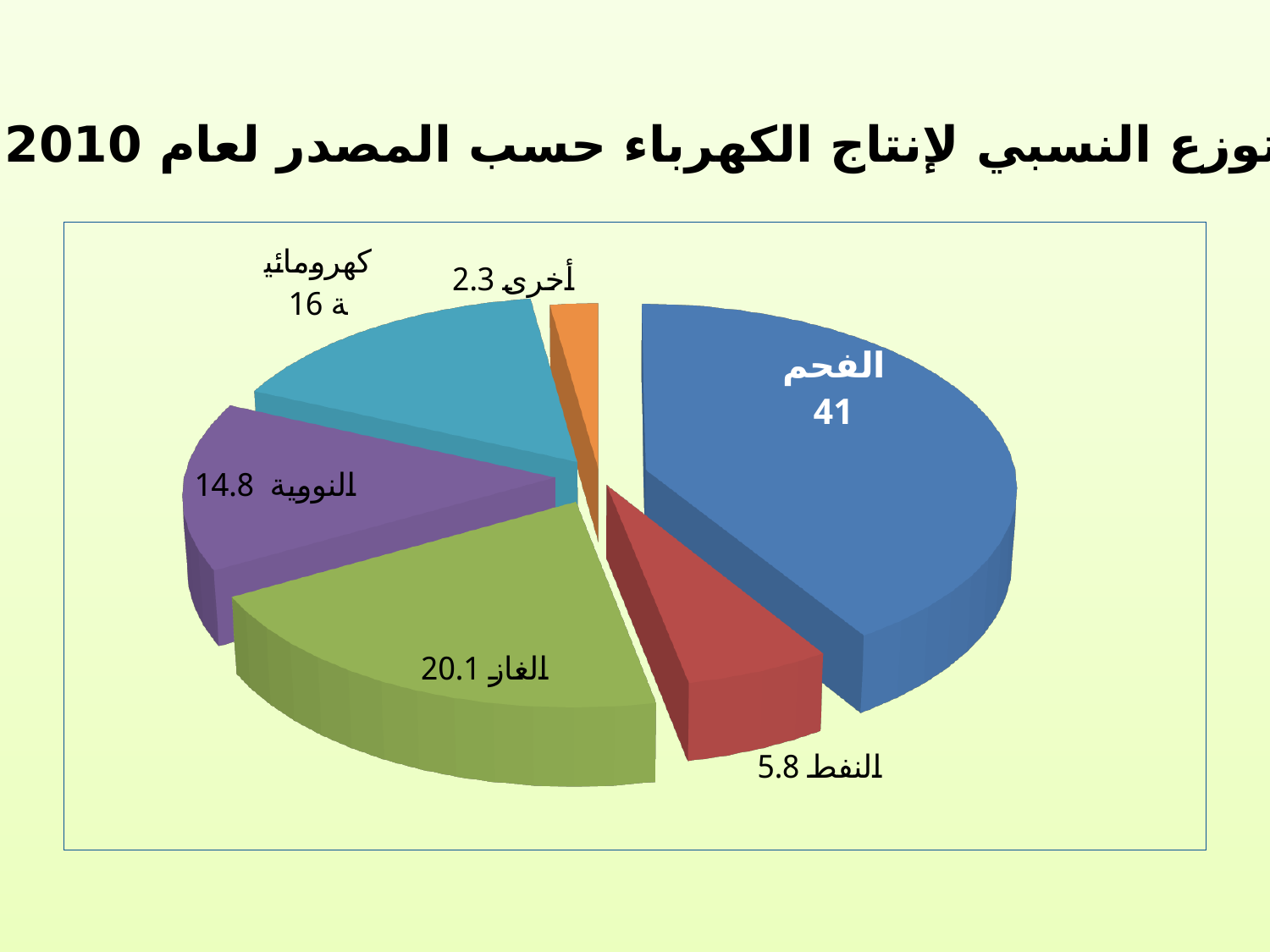
What is the value shown for كهرومائية (hydro) in the pie chart? 16 What colour is the slice for الفحم (coal)? Blue Which source has the smallest slice in the pie chart? أخرى What is the value shown for الغاز (gas) in the pie chart? 20.1 What is the value shown for النفط (oil) in the pie chart? 5.8 How many slices does the pie chart have? 6 What is the difference between the values for الفحم (coal) and الغاز (gas)? 20.9 What type of chart is shown on the slide? Pie chart Which is larger, the value for كهرومائية (hydro) or النووية (nuclear)? كهرومائية What is the value shown for النووية (nuclear) in the pie chart? 14.8 Which source has the largest slice in the pie chart? الفحم What is the value shown for الفحم (coal) in the pie chart? 41